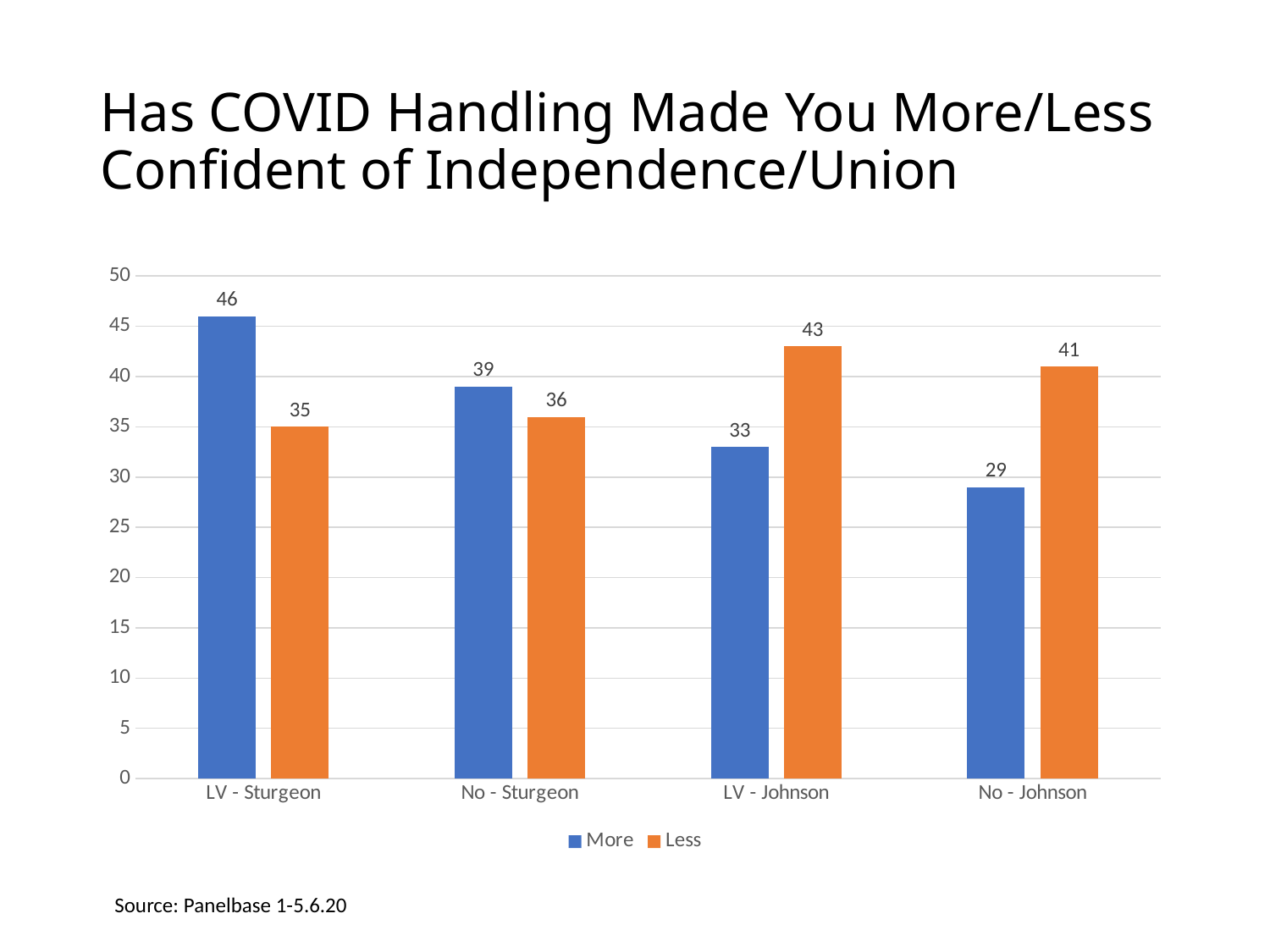
Which category has the highest "More" value? LV - Sturgeon What is the value for "More" for LV - Sturgeon? 46 What is the difference between the "Less" and "More" values for No - Johnson? 12 Which category has the lowest "More" value? No - Johnson What is the value for "Less" for LV - Johnson? 43 What is the value for "Less" for No - Johnson? 41 For No - Sturgeon, which is larger, "More" or "Less"? More What is the difference between the "More" and "Less" values for LV - Sturgeon? 11 What kind of chart is shown on the slide? Bar chart How many series does the legend list? 2 Which category has the highest "Less" value? LV - Johnson How many categories are shown on the x axis? 4